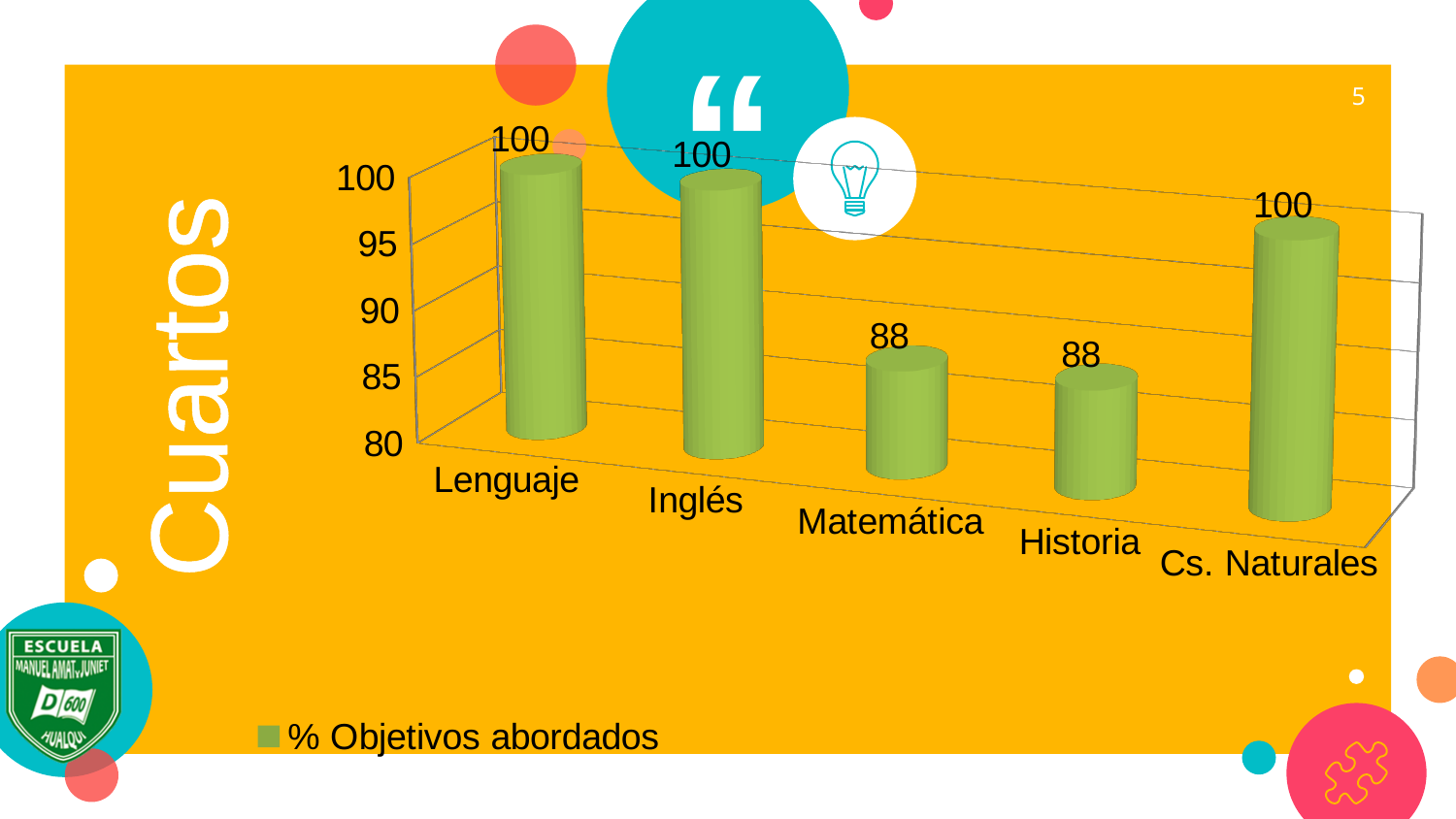
What is the value for Historia? 88 How many categories are shown on the x axis? 5 What is the value for Cs. Naturales? 100 What kind of chart is shown on the slide? bar chart Which is larger, the value for Inglés or the value for Historia? Inglés What series name does the legend show? % Objetivos abordados Which category has the lowest value? Matemática and Historia (both 88) Is the value for Matemática greater or less than 90? less What is the value for Lenguaje? 100 What is the difference between the values for Lenguaje and Matemática? 12 What is the value for Inglés? 100 What is the value for Matemática? 88